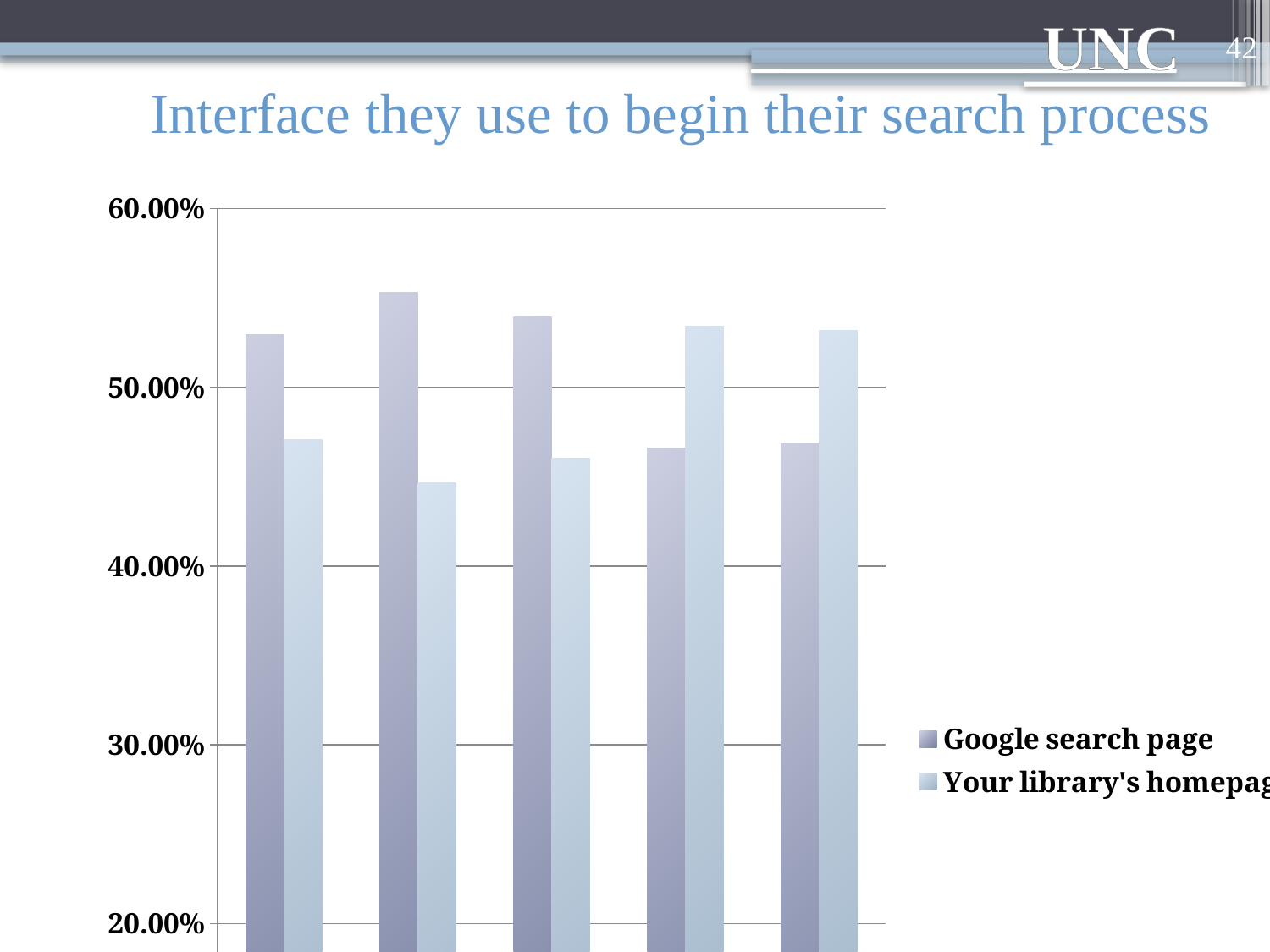
What is the title of the chart on the slide? Interface they use to begin their search process Which series is shown in the darker bars according to the legend? Google search page In the fourth group of bars, which series has the larger value, Google search page or Your library's homepage? Your library's homepage Is the Your library's homepage value for the second group of bars greater or less than 50.00%? less How many groups of bars are plotted in the chart? 5 Is the Google search page value for the first (leftmost) group of bars greater or less than 50.00%? greater What kind of chart is shown on the slide? bar chart How many series does the legend list? 2 In the first (leftmost) group of bars, which series has the larger value, Google search page or Your library's homepage? Google search page In which group of bars (counting from the left) does the Google search page series reach its highest value? second Is the Google search page value for the fifth (rightmost) group of bars greater or less than 50.00%? less